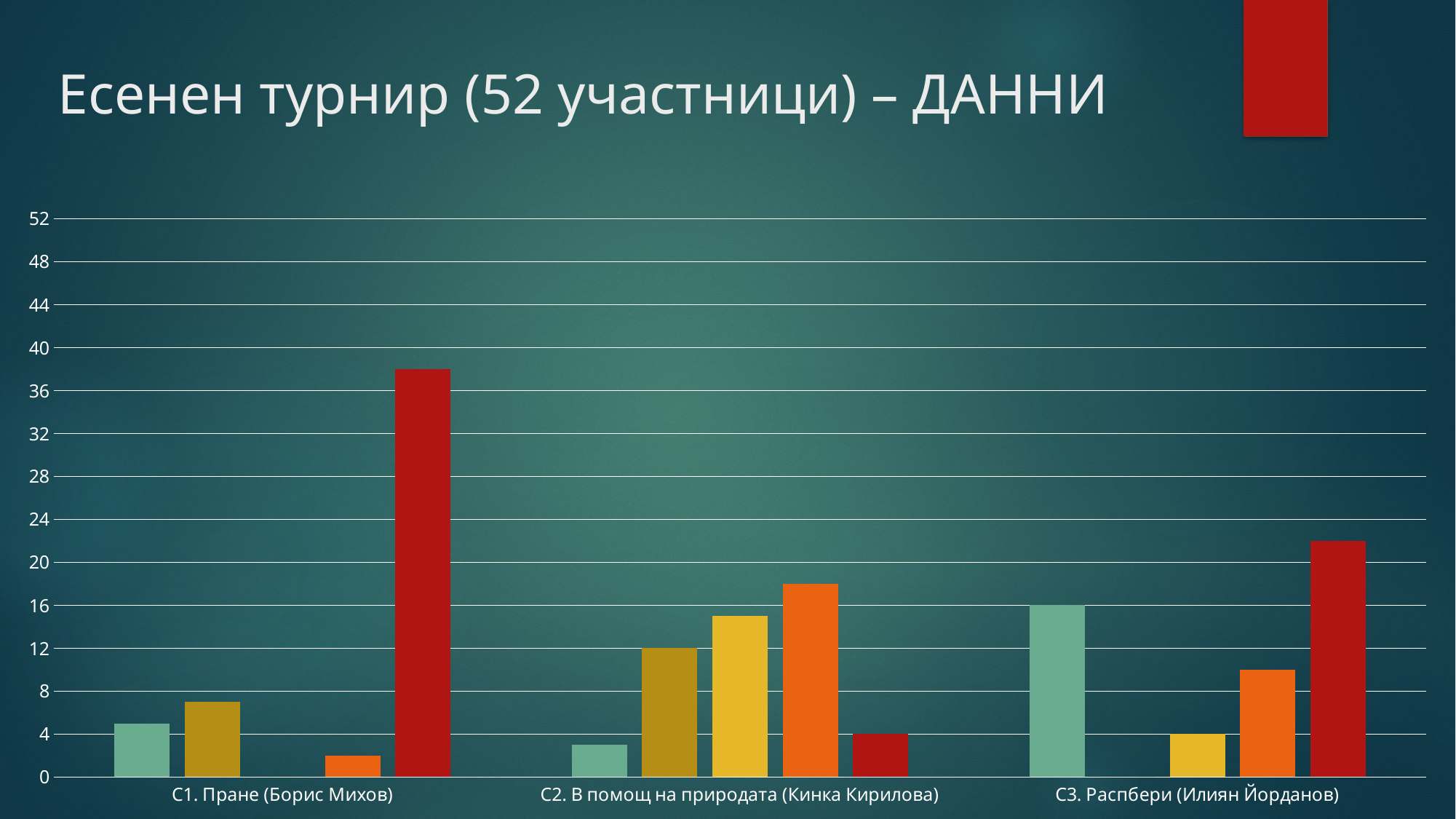
Is the value of the red bar for С1. Пране (Борис Михов) greater or less than 36? greater What is the value of the gold (second) bar for С2. В помощ на природата (Кинка Кирилова)? 12 What kind of chart is shown on the slide? bar chart What is the value of the teal (first) bar for С3. Распбери (Илиян Йорданов)? 16 Which is larger: the red bar for С1. Пране (Борис Михов) or the red bar for С3. Распбери (Илиян Йорданов)? С1. Пране (Борис Михов) What is the value of the yellow bar for С3. Распбери (Илиян Йорданов)? 4 Is the value of the red bar for С3. Распбери (Илиян Йорданов) greater or less than 20? greater How many categories are shown along the x axis of the chart? 3 Which category contains the tallest bar in the chart? С1. Пране (Борис Михов) What is the title of the slide containing the chart? Есенен турнир (52 участници) – ДАННИ Is the value of the orange bar for С1. Пране (Борис Михов) greater or less than 4? less What is the value of the red (last) bar for С2. В помощ на природата (Кинка Кирилова)? 4